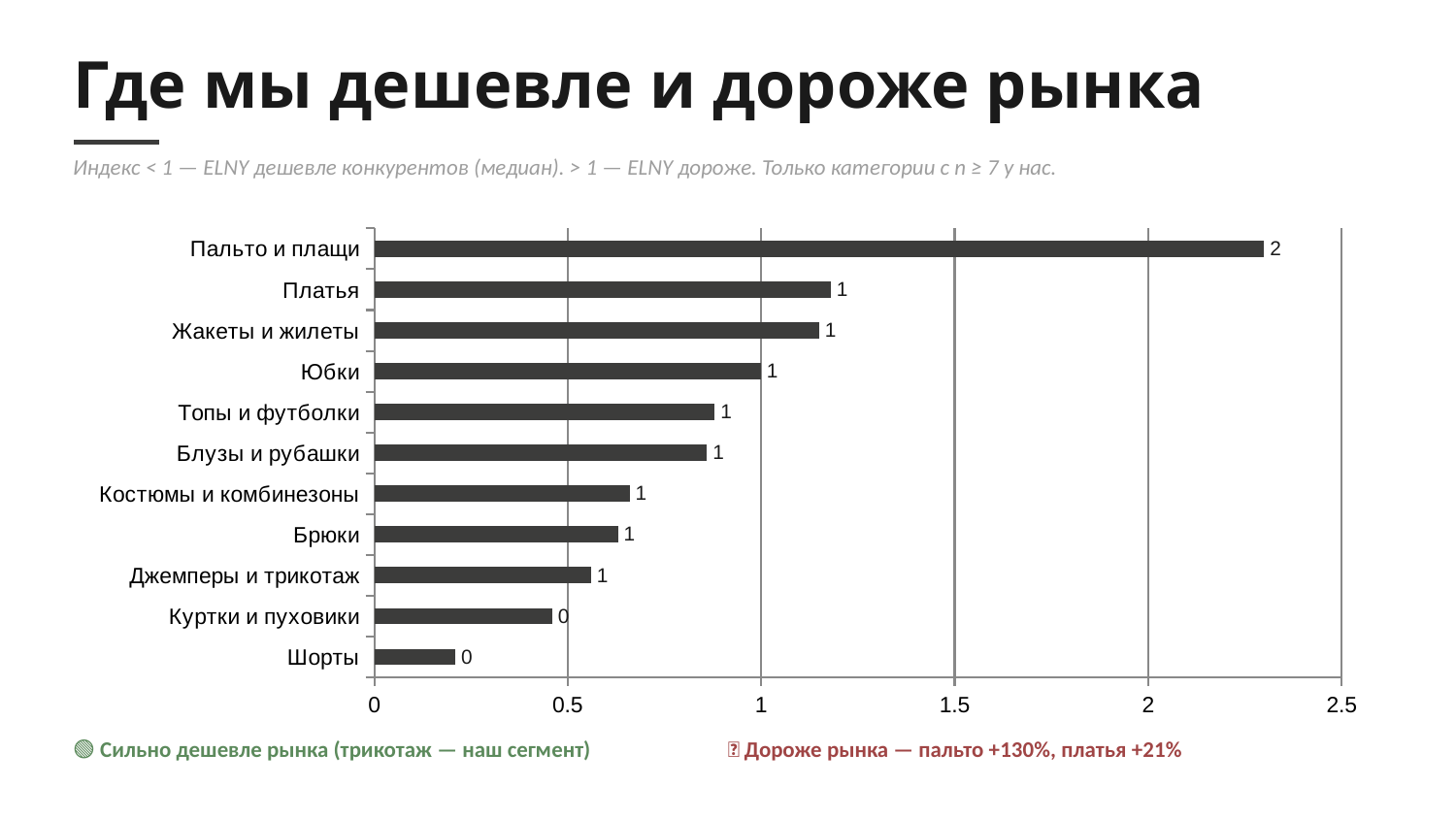
Is the value for Пальто и плащи greater or less than 2? greater Which is larger, the value for Пальто и плащи or the value for Платья? Пальто и плащи Is the value for Платья greater or less than 1? greater What is the title of the slide containing the chart? Где мы дешевле и дороже рынка How many categories are plotted in the chart? 11 Which category has the lowest value in the chart? Шорты Is the value for Топы и футболки greater or less than 1? less Which category has the highest value in the chart? Пальто и плащи What data label is shown for Шорты? 0 What data label is shown for Пальто и плащи? 2 What kind of chart is shown on the slide? bar chart